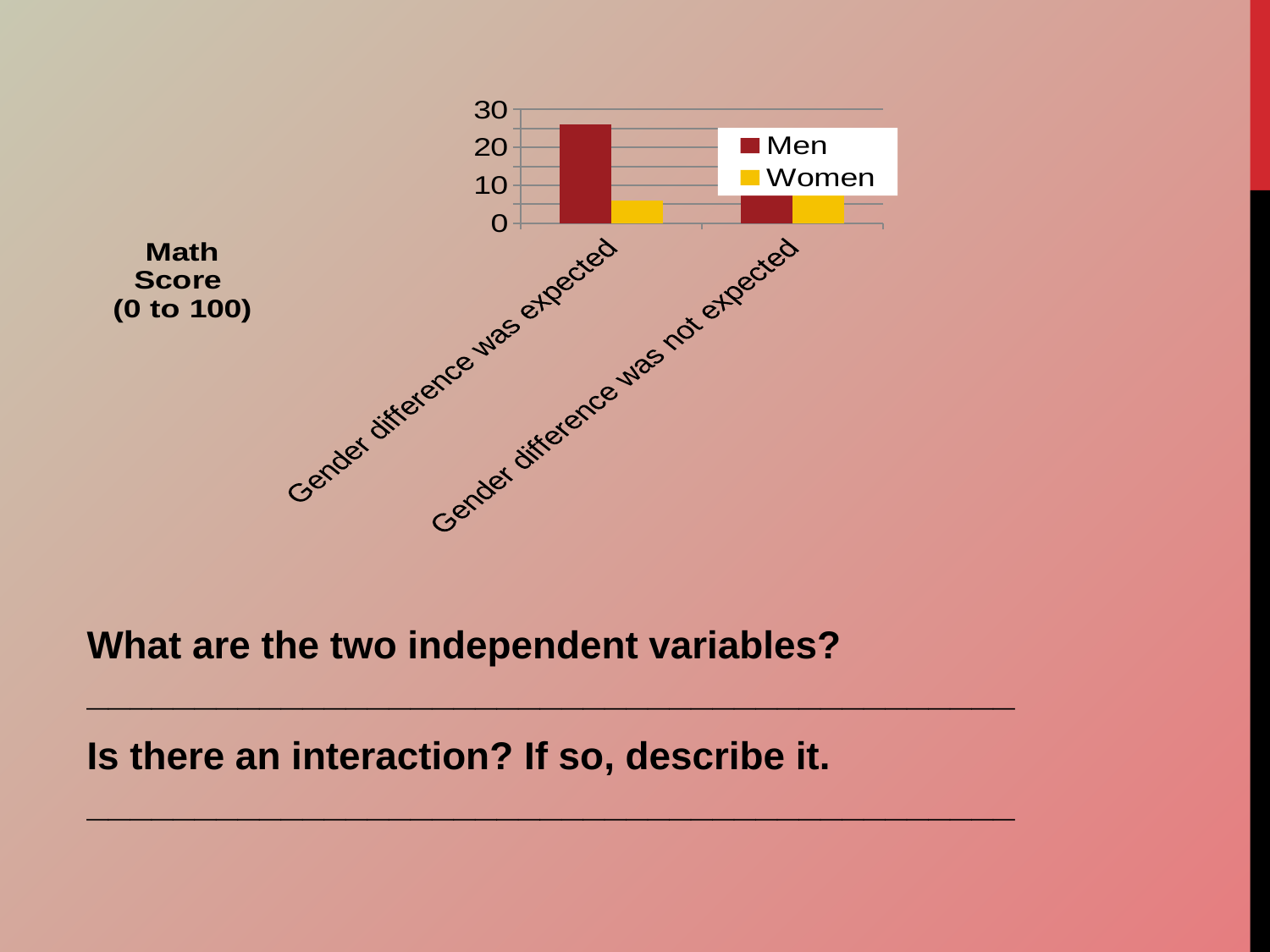
Which bar is the highest in the chart? Men, Gender difference was expected Is the value for Women in the 'Gender difference was expected' condition greater or less than 10? less What are the two series named in the legend? Men and Women Is the value for Men in the 'Gender difference was expected' condition greater or less than 20? greater How many series does the legend list? 2 In the 'Gender difference was expected' condition, which is larger, the value for Men or the value for Women? Men What is the highest value shown on the vertical axis? 30 How many categories are shown on the x axis? 2 What kind of chart is shown on the slide? bar chart What is the label of the vertical axis? Math Score (0 to 100)